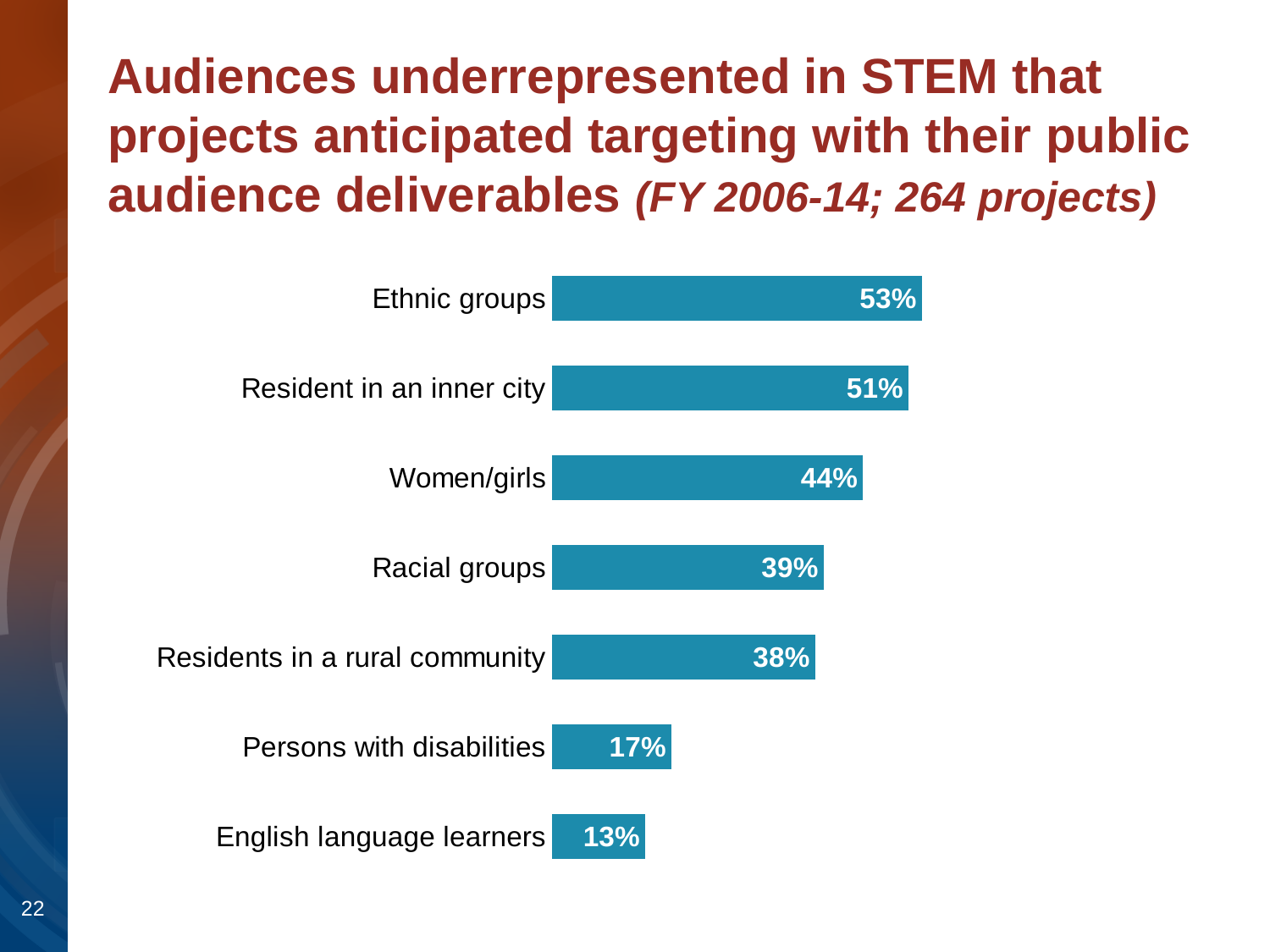
Which audience category has the lowest value? English language learners What is the difference between the values for Women/girls and Racial groups? 5% What is the value shown for Persons with disabilities? 17% What kind of chart is shown on the slide? Bar chart What is the difference between the values for Ethnic groups and English language learners? 40% Which audience category has the highest value? Ethnic groups Which is larger, the value for Resident in an inner city or the value for Women/girls? Resident in an inner city How many projects does the chart title say the data covers? 264 projects What is the value shown for Residents in a rural community? 38% What percentage of projects anticipated targeting ethnic groups? 53% How many audience categories are shown in the chart? 7 Which is larger, the value for Persons with disabilities or the value for English language learners? Persons with disabilities